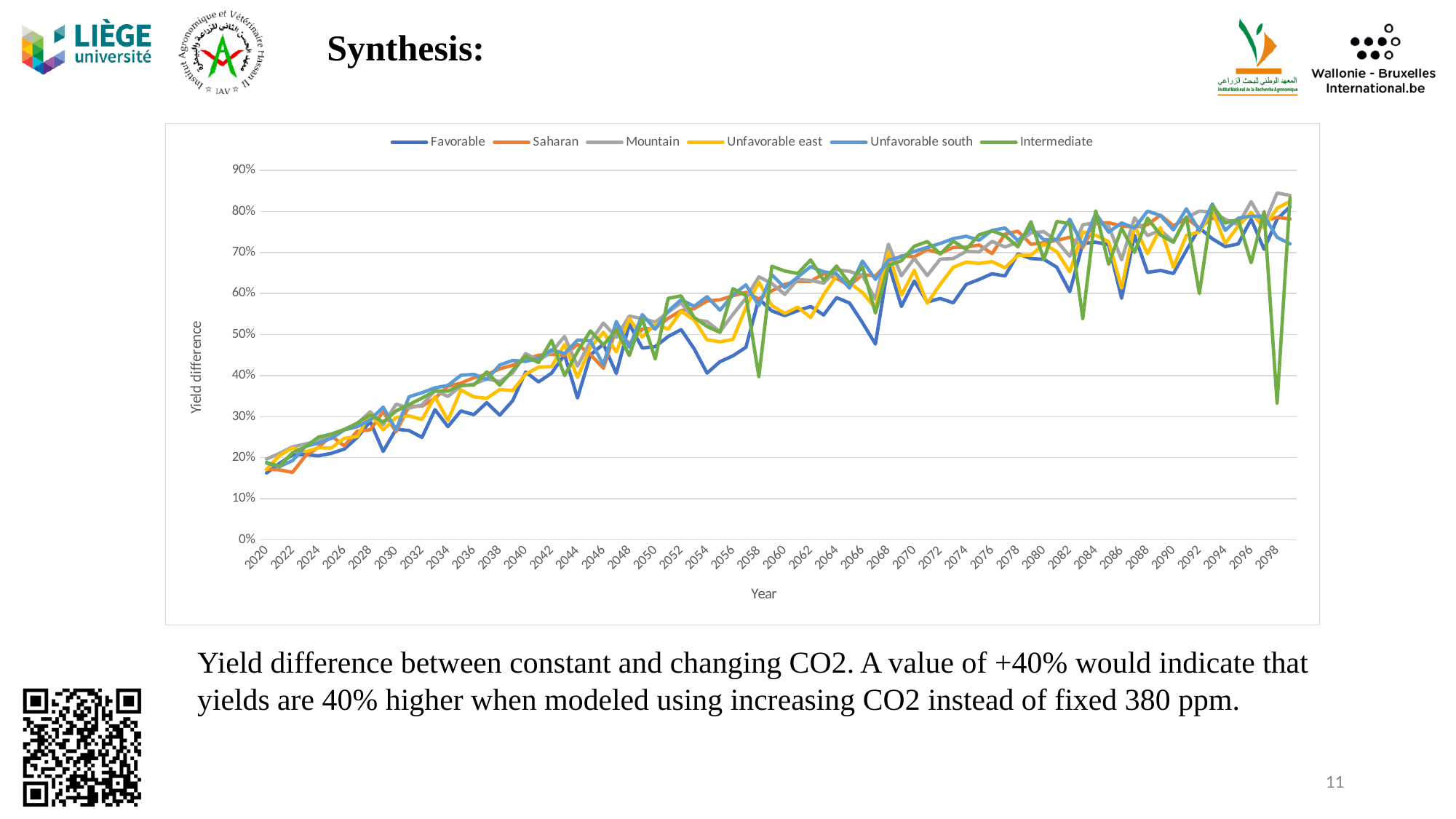
What is the label of the y axis? Yield difference Overall, do the yield difference values rise or fall from 2020 to 2098? rise How many series does the legend list? 6 What kind of chart is shown on the slide? line chart Is the value for Intermediate in 2098 greater or less than 40%? less Is the value for Intermediate in 2084 greater or less than 60%? greater What is the label of the x axis? Year Is the value for Favorable in 2020 greater or less than 20%? less Which series has the lowest value in 2098? Intermediate In 2098, which is larger, the value for Mountain or the value for Intermediate? Mountain